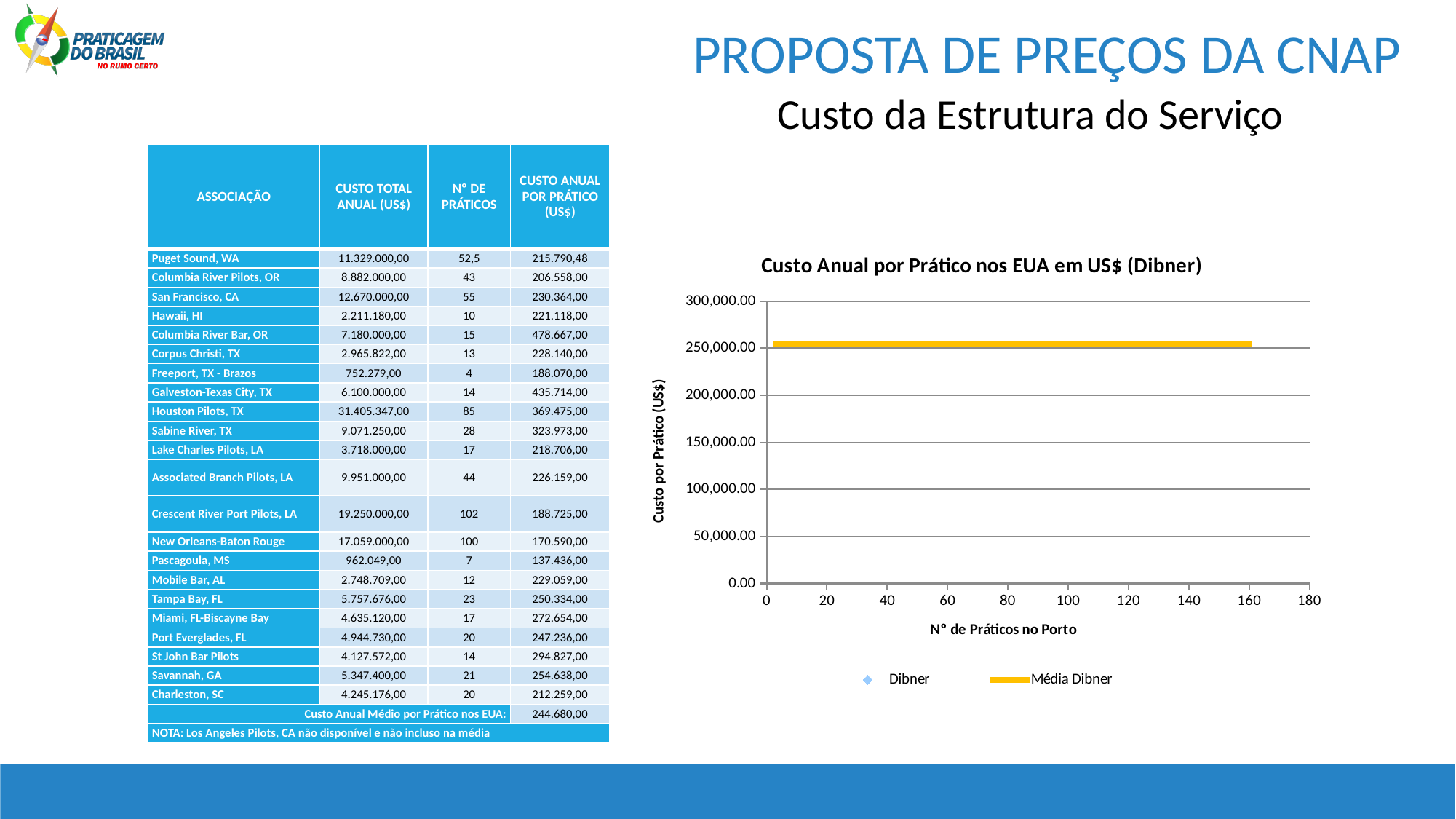
How many series does the chart's legend list? 2 Is the value of the Média Dibner line greater or less than 200,000.00? greater Does the Média Dibner line rise, fall, or stay flat along the x axis? stays flat What is the title of the chart on the slide? Custo Anual por Prático nos EUA em US$ (Dibner) What are the two series named in the chart's legend? Dibner and Média Dibner Is the value of the Média Dibner line greater or less than 300,000.00? less